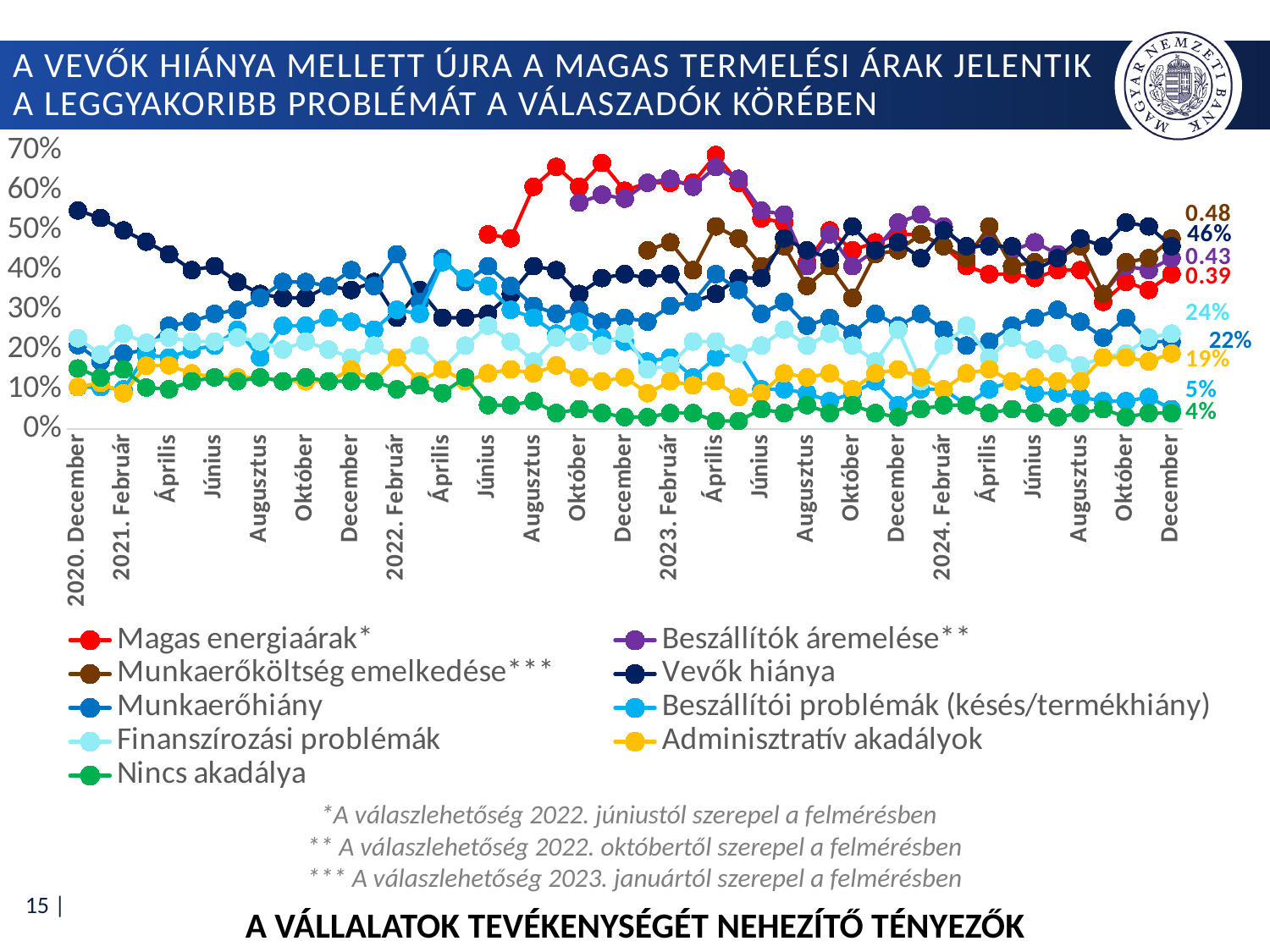
How many series does the legend list? 9 Is the value for Vevők hiánya at 2020. December greater or less than 50%? greater What is the difference between the final labelled values of Vevők hiánya (46%) and Finanszírozási problémák (24%)? 22 percentage points What is the final value labelled for the Nincs akadálya series? 4% What is the final value labelled for the Munkaerőköltség emelkedése series? 0.48 Which series has the lowest labelled value at the end of the chart? Nincs akadálya What is the final value labelled for the Adminisztratív akadályok series? 19% At the end of the chart, which is larger: the value for Finanszírozási problémák or the value for Munkaerőhiány? Finanszírozási problémák Which series has the highest labelled value at the end of the chart? Munkaerőköltség emelkedése What is the final (December 2024) value labelled for the Vevők hiánya series? 46% What is the final value labelled for the Magas energiaárak series? 0.39 What type of chart is shown on the slide? line chart